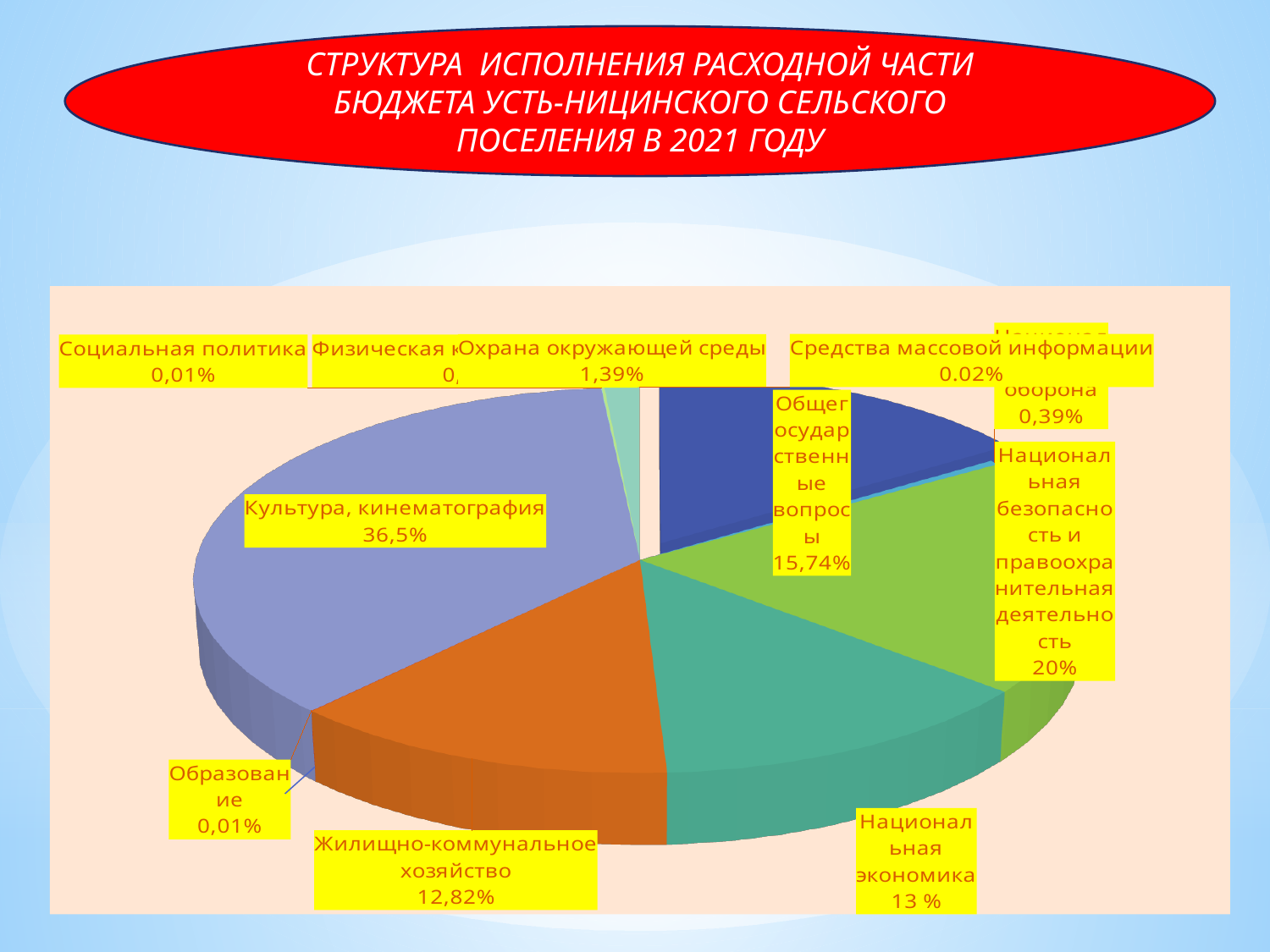
Which is larger: the share of Национальная экономика or the share of Общегосударственные вопросы? Общегосударственные вопросы What is the difference between the shares of Общегосударственные вопросы and Жилищно-коммунальное хозяйство? 2,92% Which year does the chart title say the budget expenditure structure refers to? 2021 What is the value shown for Общегосударственные вопросы? 15,74% What is the value shown for Жилищно-коммунальное хозяйство? 12,82% What is the value shown for Национальная безопасность и правоохранительная деятельность? 20% What is the value shown for Охрана окружающей среды? 1,39% What share of the pie does Культура, кинематография have? 36,5% Which category has the largest share of the pie? Культура, кинематография What is the value shown for Средства массовой информации? 0.02% What kind of chart is shown on the slide? pie chart What is the difference between the shares of Культура, кинематография and Национальная безопасность и правоохранительная деятельность? 16,5%